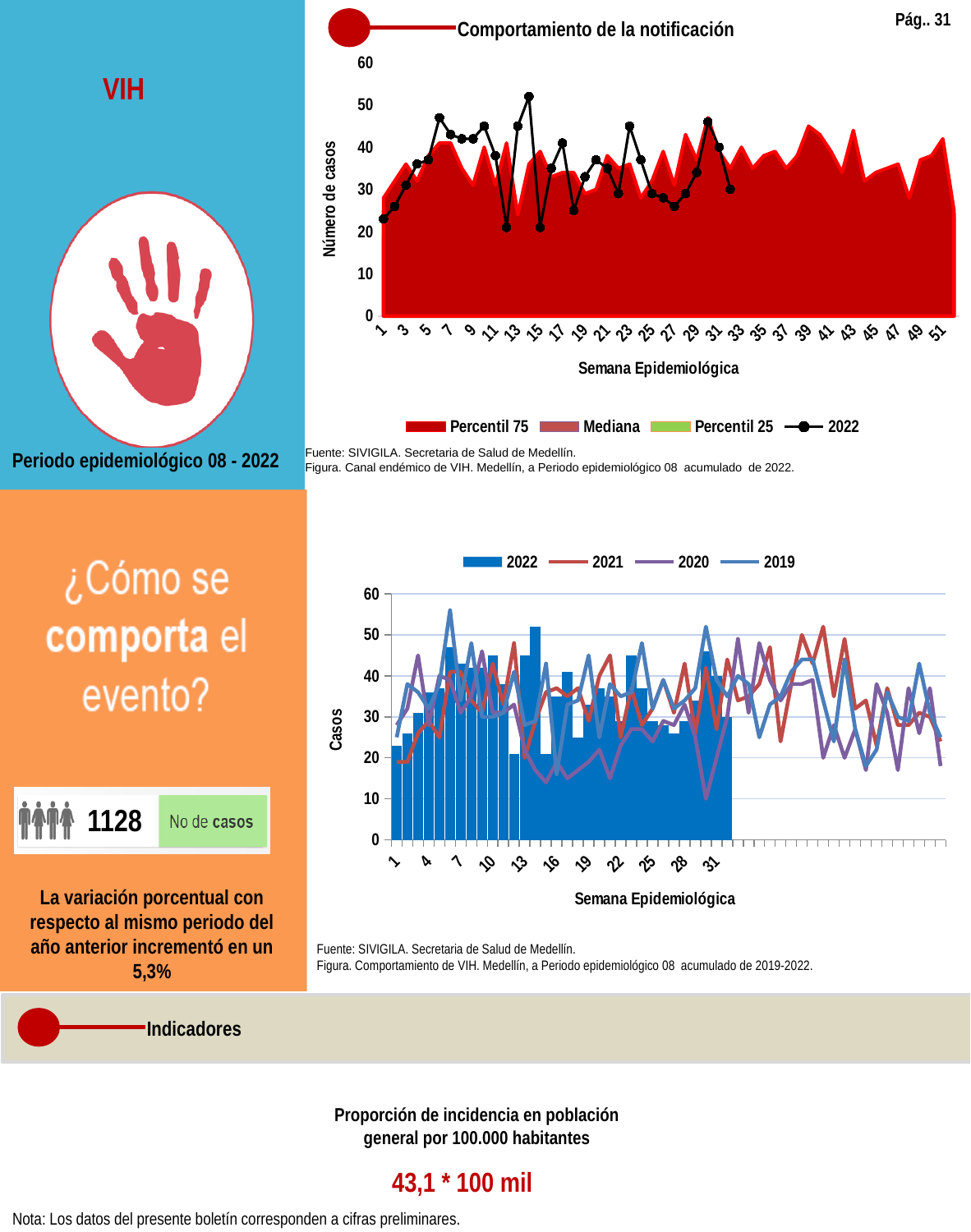
In the top chart 'Comportamiento de la notificación', is the 2022 value for week 12 greater or less than 30? less In the bottom chart, is the 2022 value for week 1 greater or less than 30? less In the top chart 'Comportamiento de la notificación', at which epidemiological week does the 2022 line reach its highest value? 14 In the top chart 'Comportamiento de la notificación', how many series does the legend list? 4 In the top chart 'Comportamiento de la notificación', is the 2022 value for week 14 greater or less than 50? greater In the bottom chart, which series is plotted as bars? 2022 In the bottom chart, how many series does the legend list? 4 In the top chart 'Comportamiento de la notificación', which legend entry is drawn as a black line with markers? 2022 In the top chart 'Comportamiento de la notificación', what is the label of the vertical axis? Número de casos